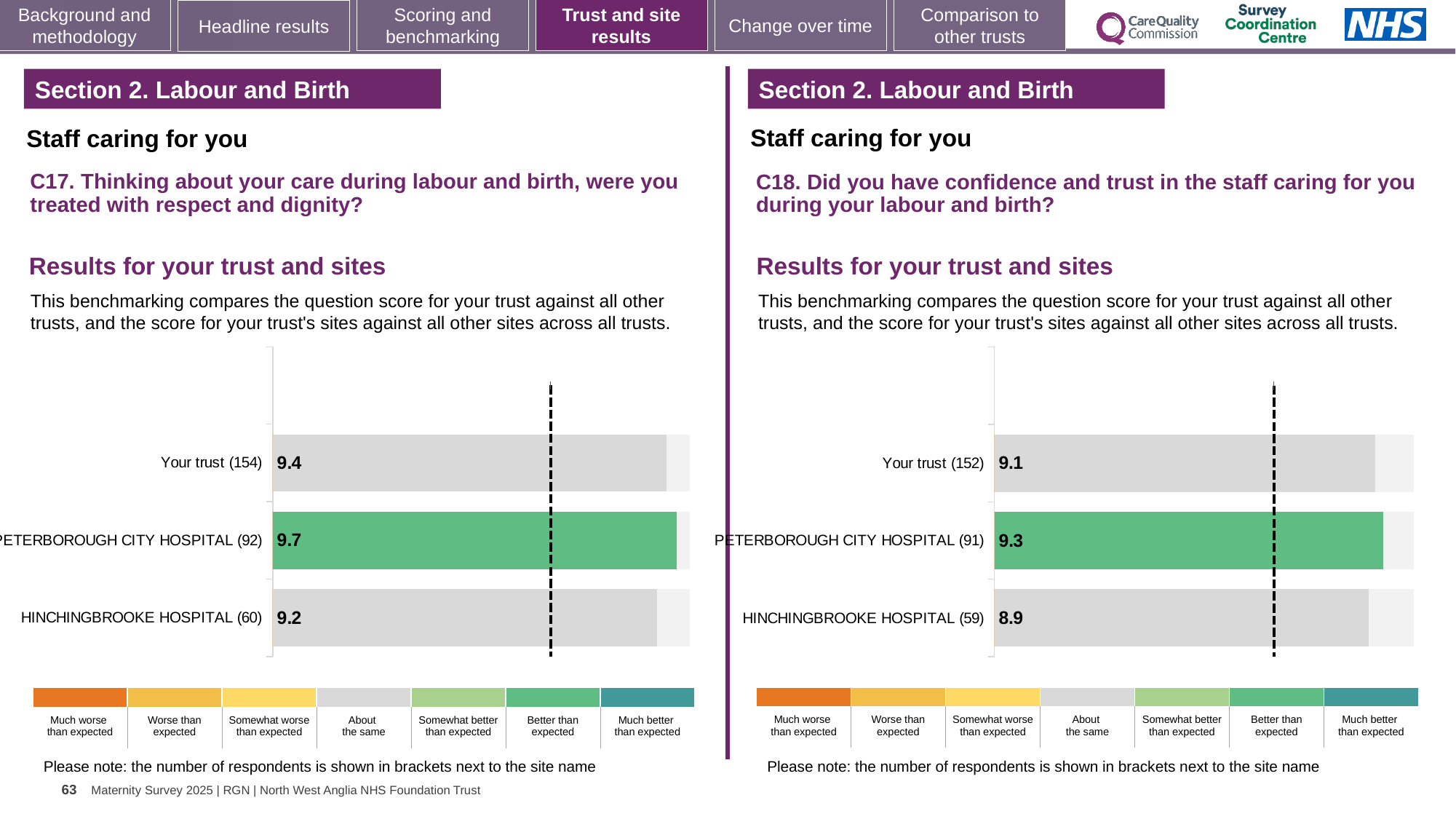
On the C17 chart (left), which bar has the highest score? PETERBOROUGH CITY HOSPITAL What type of chart is used on the C18 chart (right)? Bar chart On the C18 chart (right), what is the difference between the PETERBOROUGH CITY HOSPITAL score and the Your trust score? 0.2 On the C17 chart (left), what is the score for HINCHINGBROOKE HOSPITAL? 9.2 On the C18 chart (right), which bar has the lowest score? HINCHINGBROOKE HOSPITAL On the C17 chart (left), what is the score for Your trust? 9.4 On the C17 chart (left), what is the difference between the PETERBOROUGH CITY HOSPITAL score and the HINCHINGBROOKE HOSPITAL score? 0.5 On the C17 chart (left), what is the score for PETERBOROUGH CITY HOSPITAL? 9.7 On the C18 chart (right), which has the larger score, Your trust or HINCHINGBROOKE HOSPITAL? Your trust How many bars are shown on the C17 chart (left)? 3 On the C18 chart (right), what is the score for HINCHINGBROOKE HOSPITAL? 8.9 On the C18 chart (right), what is the score for Your trust? 9.1